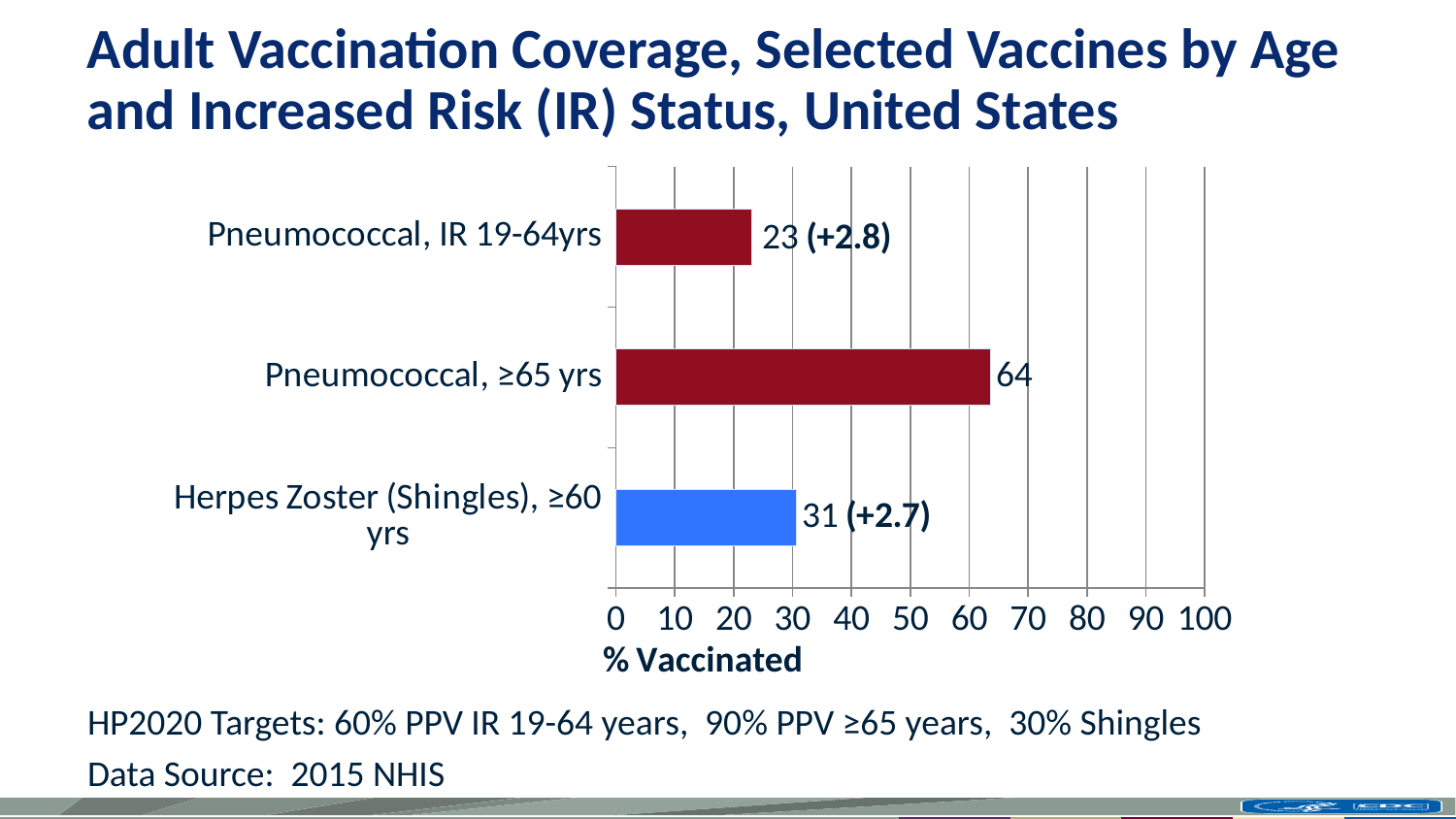
How many categories are shown in the chart? 3 Which category has the lowest % vaccinated? Pneumococcal, IR 19-64yrs What is the % vaccinated for Pneumococcal, ≥65 yrs? 64 What kind of chart is shown on the slide? Bar chart Which has a higher % vaccinated: Pneumococcal, IR 19-64yrs or Herpes Zoster (Shingles), ≥60 yrs? Herpes Zoster (Shingles), ≥60 yrs What is the difference in % vaccinated between Pneumococcal, ≥65 yrs and Herpes Zoster (Shingles), ≥60 yrs? 33 What is the % vaccinated for Herpes Zoster (Shingles), ≥60 yrs? 31 Is the value for Pneumococcal, ≥65 yrs greater or less than 50? greater What is the % vaccinated for Pneumococcal, IR 19-64yrs? 23 What is the label of the horizontal axis? % Vaccinated What change is shown in parentheses next to the Herpes Zoster (Shingles), ≥60 yrs bar? (+2.7) Which category has the highest % vaccinated? Pneumococcal, ≥65 yrs